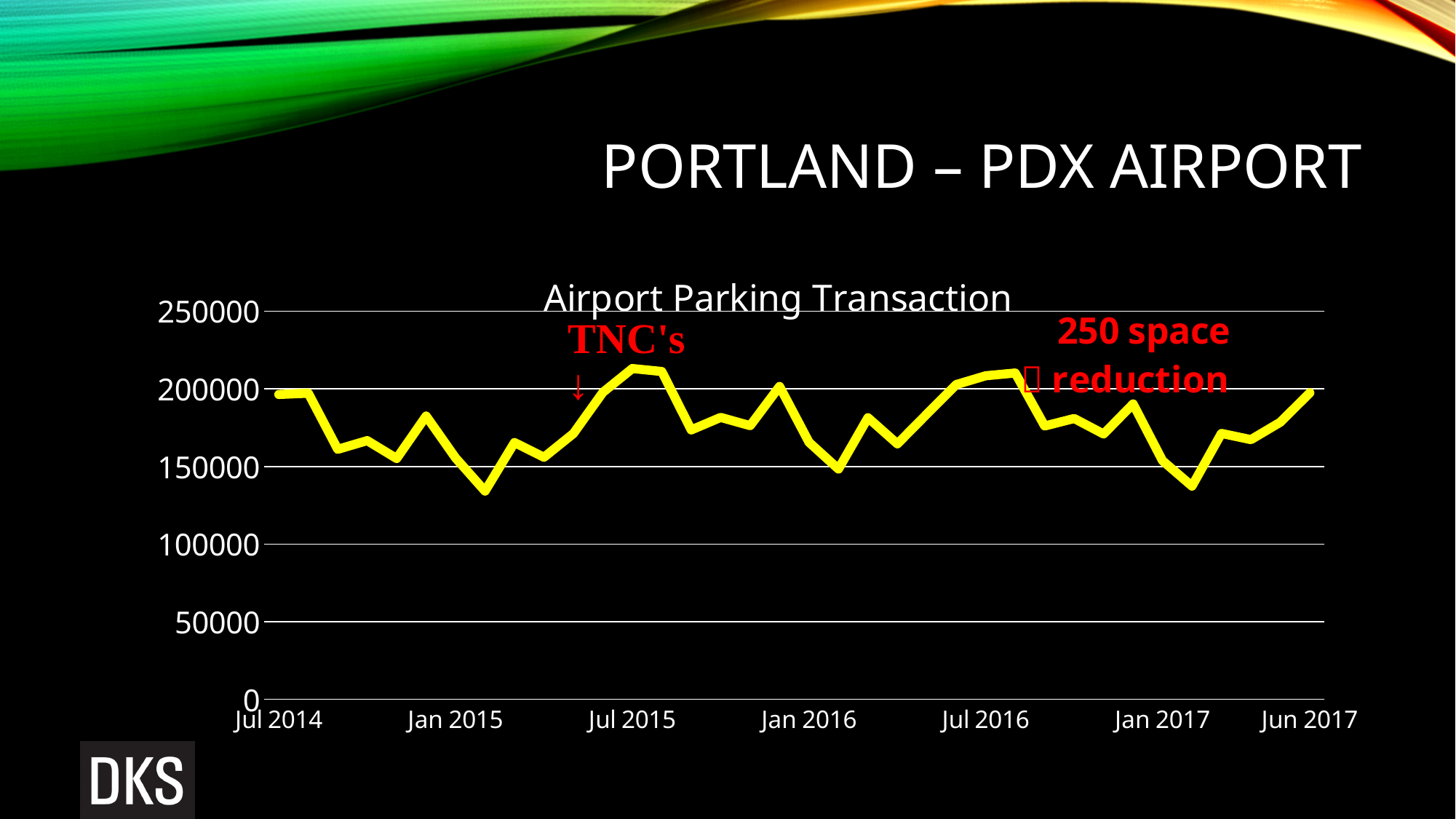
Is the value for Jan 2017 greater or less than 200000? less What kind of chart is shown on the slide? line chart What is the title of the chart? Airport Parking Transaction Does the line rise or fall from Jul 2014 to Jan 2015? fall What is the highest value shown on the vertical axis? 250000 Is the value for Jul 2015 greater or less than 200000? greater Which is larger, the value for Jul 2015 or the value for Jan 2017? Jul 2015 How many date labels are shown along the x axis? 7 Which is larger, the value for Jul 2015 or the value for Jan 2015? Jul 2015 Which is larger, the value for Jan 2015 or the value for Jul 2016? Jul 2016 Is the value for Jun 2017 greater or less than 150000? greater